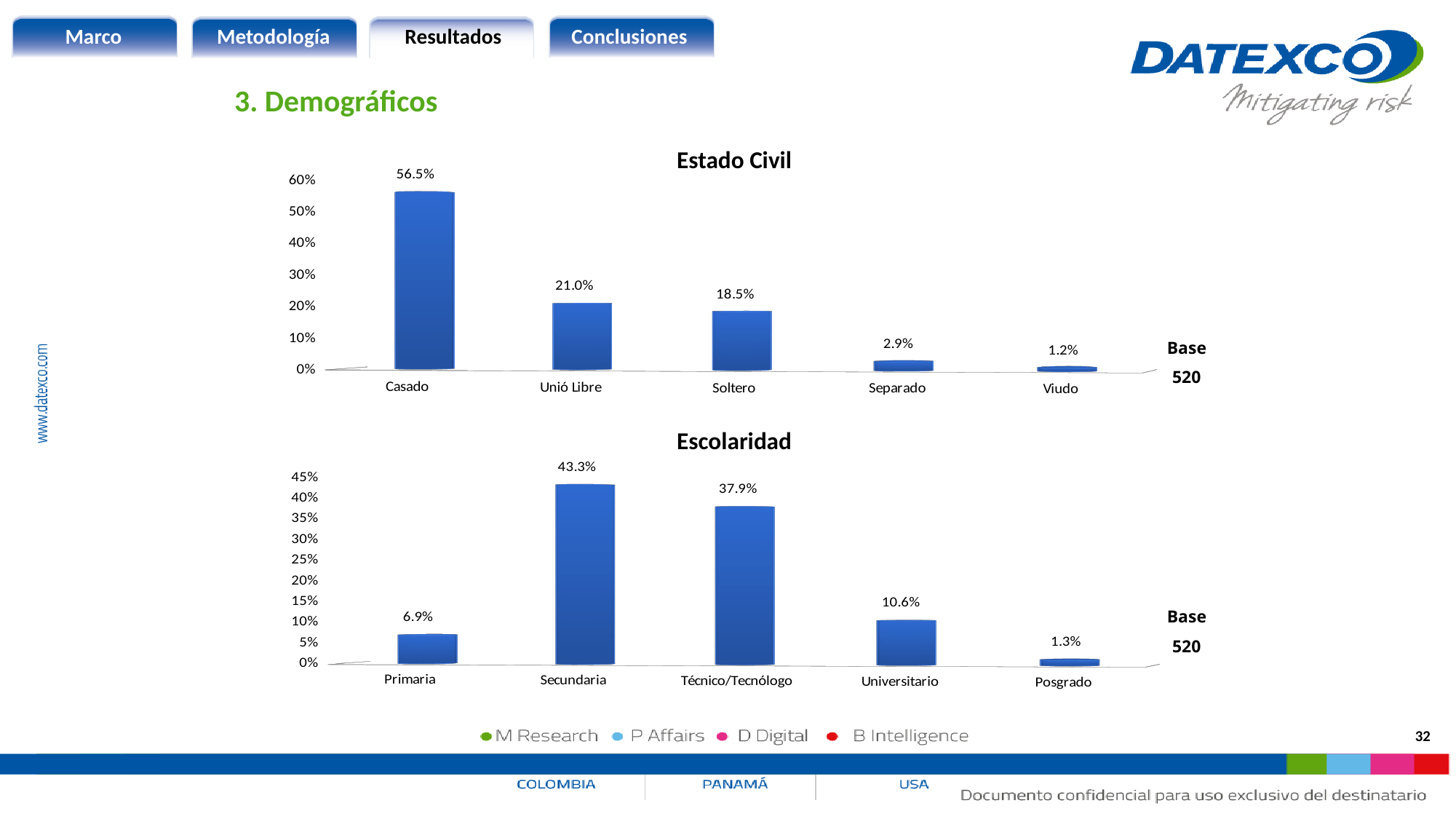
In the Escolaridad chart, what is the value for Posgrado? 1.3% In the Estado Civil chart, what is the base shown next to the chart? 520 In the Escolaridad chart, which is larger, Primaria or Posgrado? Primaria What kind of chart is the Escolaridad chart? Bar chart In the Estado Civil chart, what is the difference between Casado and Unió Libre? 35.5% In the Estado Civil chart, how many categories are shown? 5 In the Estado Civil chart, what is the value for Casado? 56.5% In the Estado Civil chart, which category has the lowest value? Viudo In the Escolaridad chart, which category has the highest value? Secundaria In the Escolaridad chart, what is the difference between Secundaria and Técnico/Tecnólogo? 5.4% In the Estado Civil chart, what is the value for Soltero? 18.5% In the Escolaridad chart, what is the value for Universitario? 10.6%